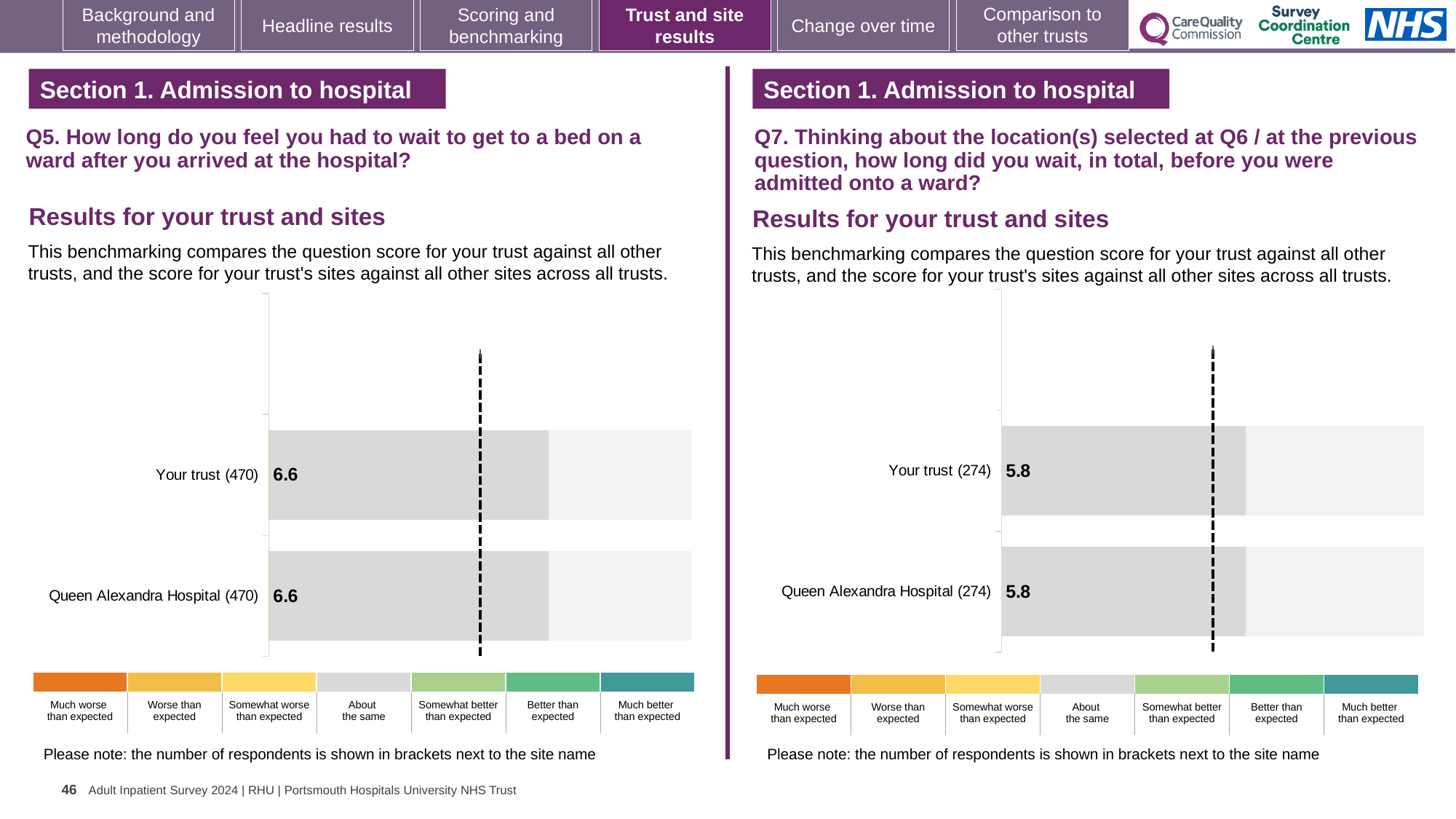
In the right chart (Q7), how many respondents are shown in brackets next to Queen Alexandra Hospital? 274 In the right chart (Q7), what is the score for Queen Alexandra Hospital? 5.8 In the left chart (Q5), what is the difference between the score for Your trust and the score for Queen Alexandra Hospital? 0 How many bars are plotted in the right chart (Q7)? 2 In the left chart (Q5), how many respondents are shown in brackets next to Your trust? 470 In the right chart (Q7), what is the score for Your trust? 5.8 In the right chart (Q7), what is the difference between the score for Your trust and the score for Queen Alexandra Hospital? 0 Is the score for Your trust in the right chart (Q7) greater or less than the score for Your trust in the left chart (Q5)? less What kind of chart is used for the Q5 results on the left? Bar chart In the left chart (Q5), what is the score for Your trust? 6.6 In the left chart (Q5), what is the score for Queen Alexandra Hospital? 6.6 How many bars are plotted in the left chart (Q5)? 2